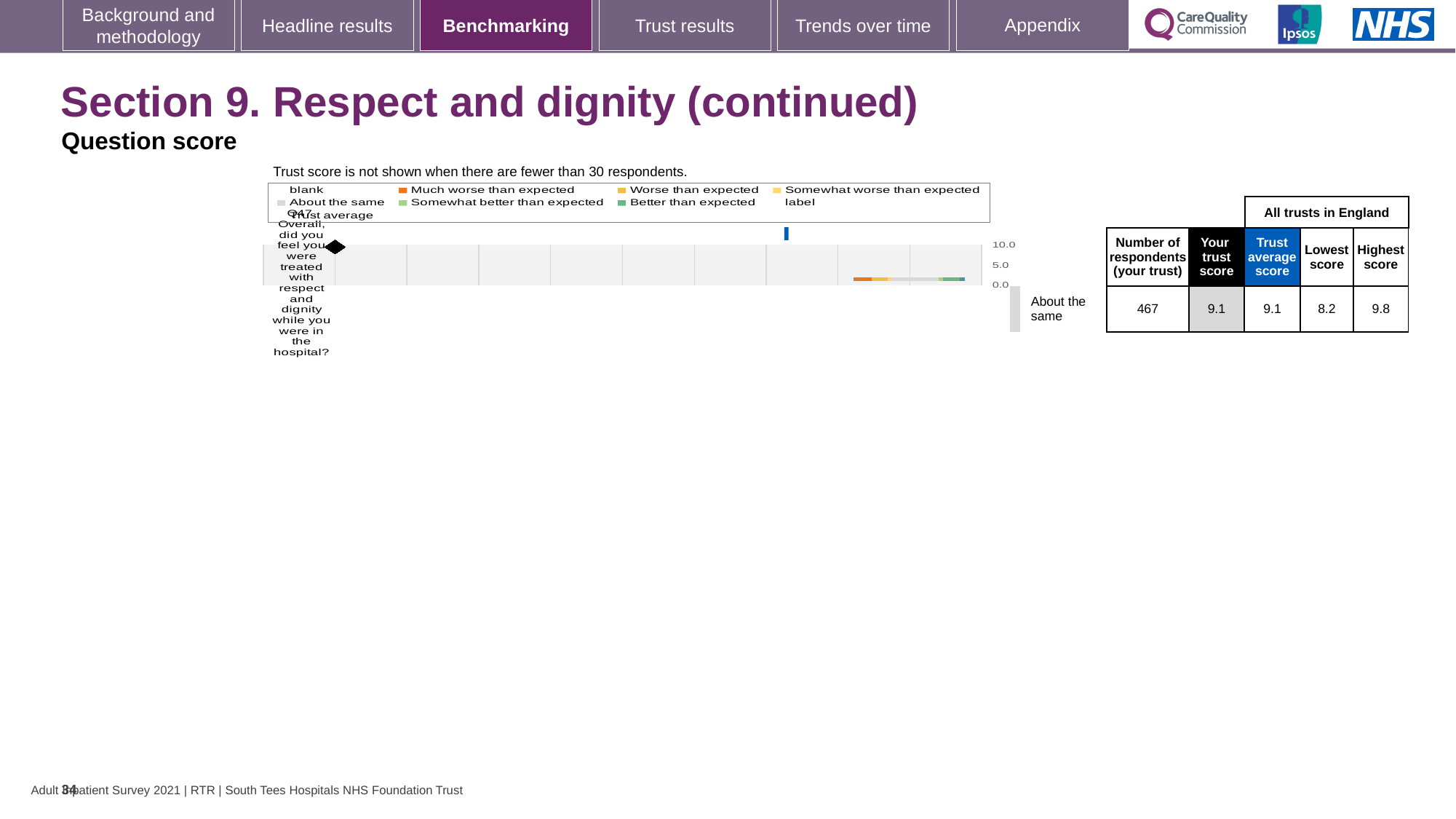
Is your trust score for Q47 greater or less than 5.0 on the chart axis? greater What is your trust score for Q47? 9.1 What is the lowest score among all trusts in England for Q47? 8.2 What is the number of respondents for your trust shown for Q47? 467 How many questions are plotted on the chart? 1 What is the highest score among all trusts in England for Q47? 9.8 What is the difference between the highest score and the lowest score for Q47? 1.6 What is the trust average score for Q47 across all trusts in England? 9.1 Is your trust score for Q47 larger than, smaller than, or equal to the trust average score? equal What kind of chart is shown on the slide? bar chart What benchmark category is shown for Q47 next to the chart? About the same What is the maximum value shown on the chart's vertical axis? 10.0